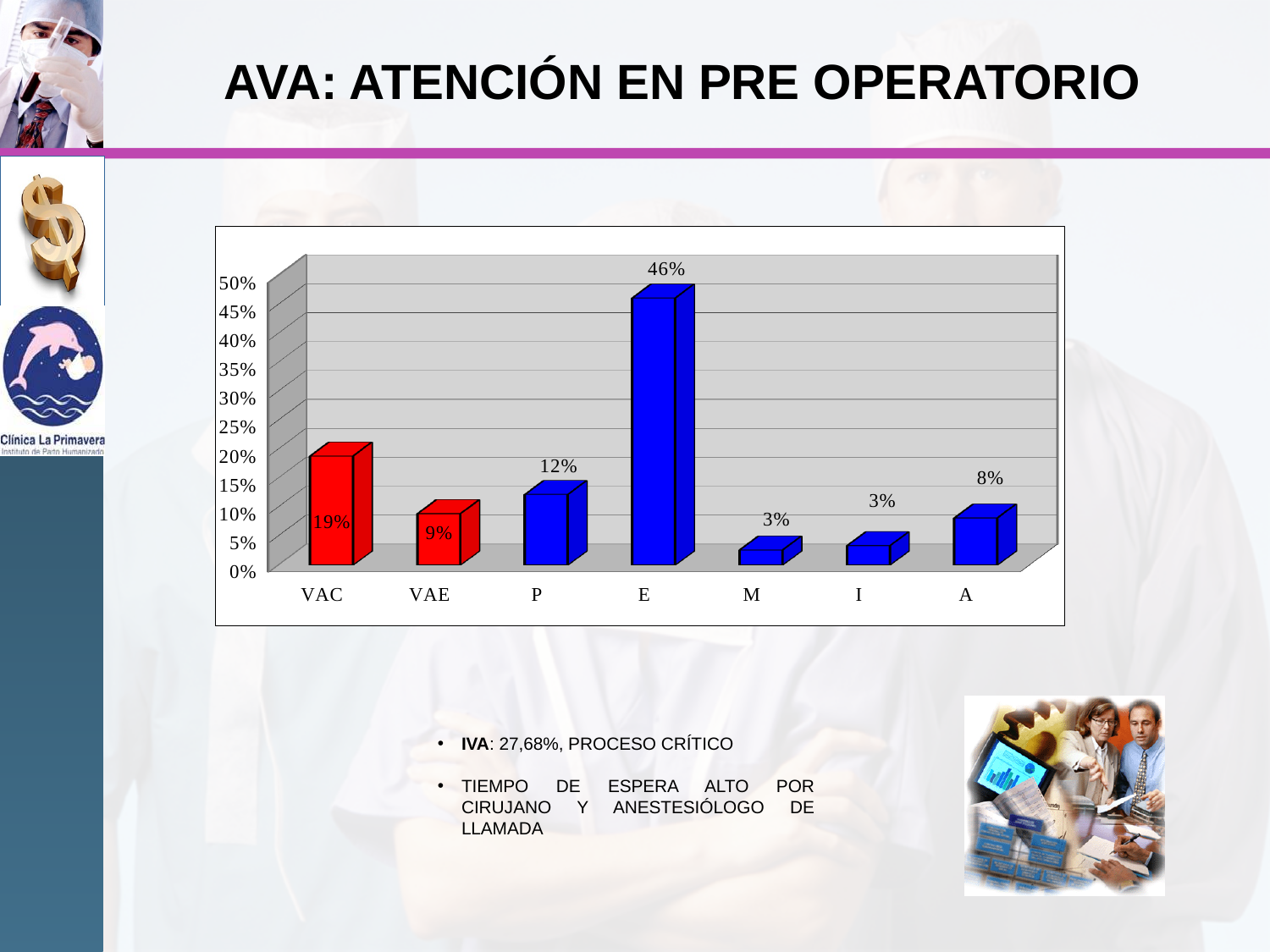
What kind of chart is shown? bar chart Is the value for E greater or less than 40%? greater Which category has the highest value? E What is the value for E? 46% How many categories are shown on the x axis? 7 Which categories are shown with red bars? VAC and VAE What is the difference between the values for P and VAE? 3% What is the value for A? 8% What is the value for M? 3% What is the value for VAC? 19% Which is larger, the value for VAE or the value for A? VAE What is the difference between the values for E and VAC? 27%